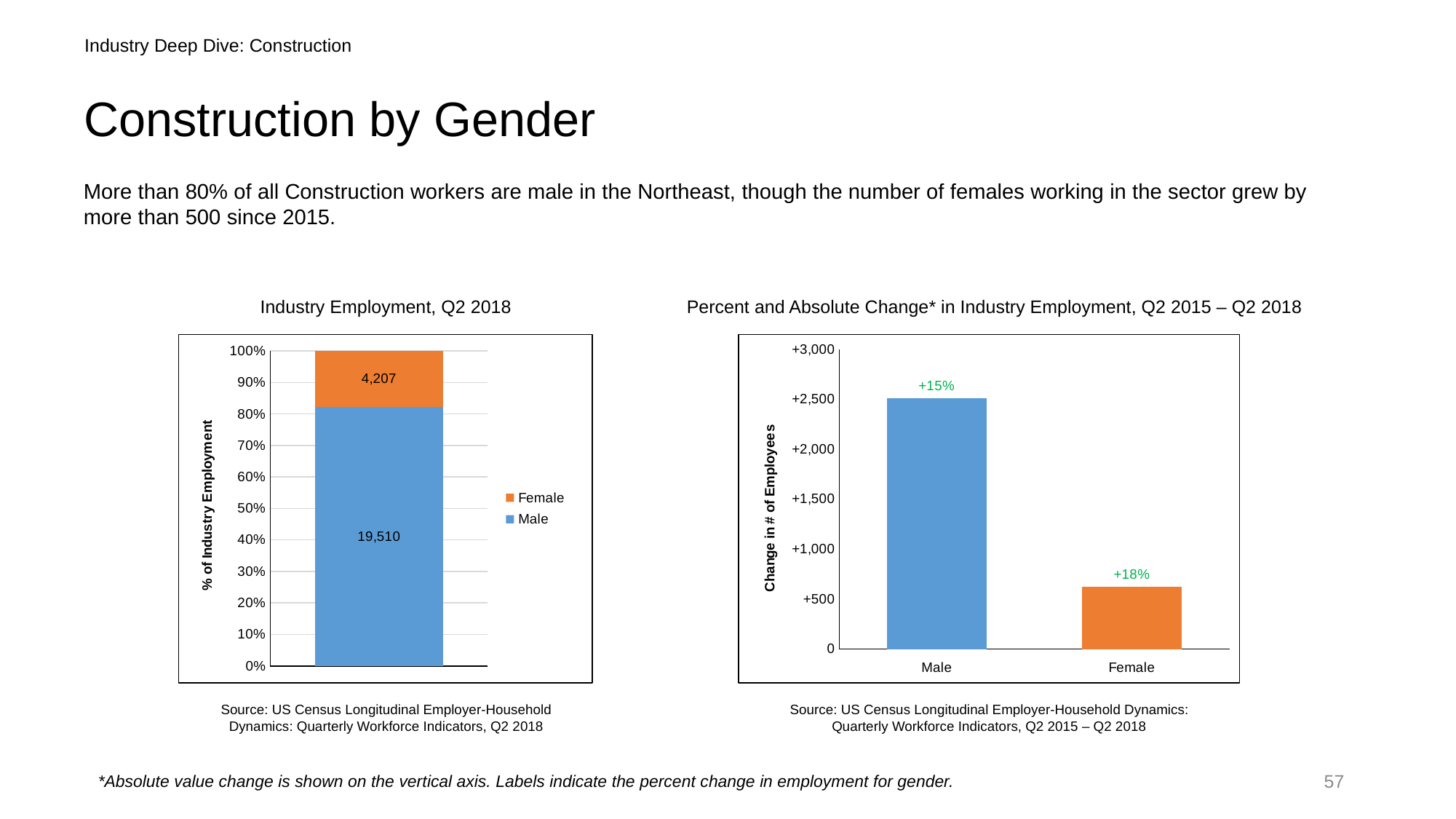
In the 'Industry Employment, Q2 2018' chart, which colour represents Female? Orange In the 'Percent and Absolute Change in Industry Employment, Q2 2015 – Q2 2018' chart, what percent change label is shown for Female? +18% In the 'Industry Employment, Q2 2018' chart, what is the value shown for Female? 4,207 In the 'Industry Employment, Q2 2018' chart, how many series does the legend list? 2 In the 'Percent and Absolute Change in Industry Employment, Q2 2015 – Q2 2018' chart, which category has the taller bar? Male In the 'Industry Employment, Q2 2018' chart, what is the value shown for Male? 19,510 In the 'Percent and Absolute Change in Industry Employment, Q2 2015 – Q2 2018' chart, is the bar for Female greater or less than +1,000? less In the 'Industry Employment, Q2 2018' chart, what is the total of the stacked bar (Male plus Female)? 23,717 In the 'Percent and Absolute Change in Industry Employment, Q2 2015 – Q2 2018' chart, what percent change label is shown for Male? +15% In the 'Industry Employment, Q2 2018' chart, what is the difference between the Male and Female values? 15,303 What kind of chart is the 'Percent and Absolute Change in Industry Employment, Q2 2015 – Q2 2018' chart? Bar chart In the 'Percent and Absolute Change in Industry Employment, Q2 2015 – Q2 2018' chart, is the bar for Male greater or less than +2,000? greater